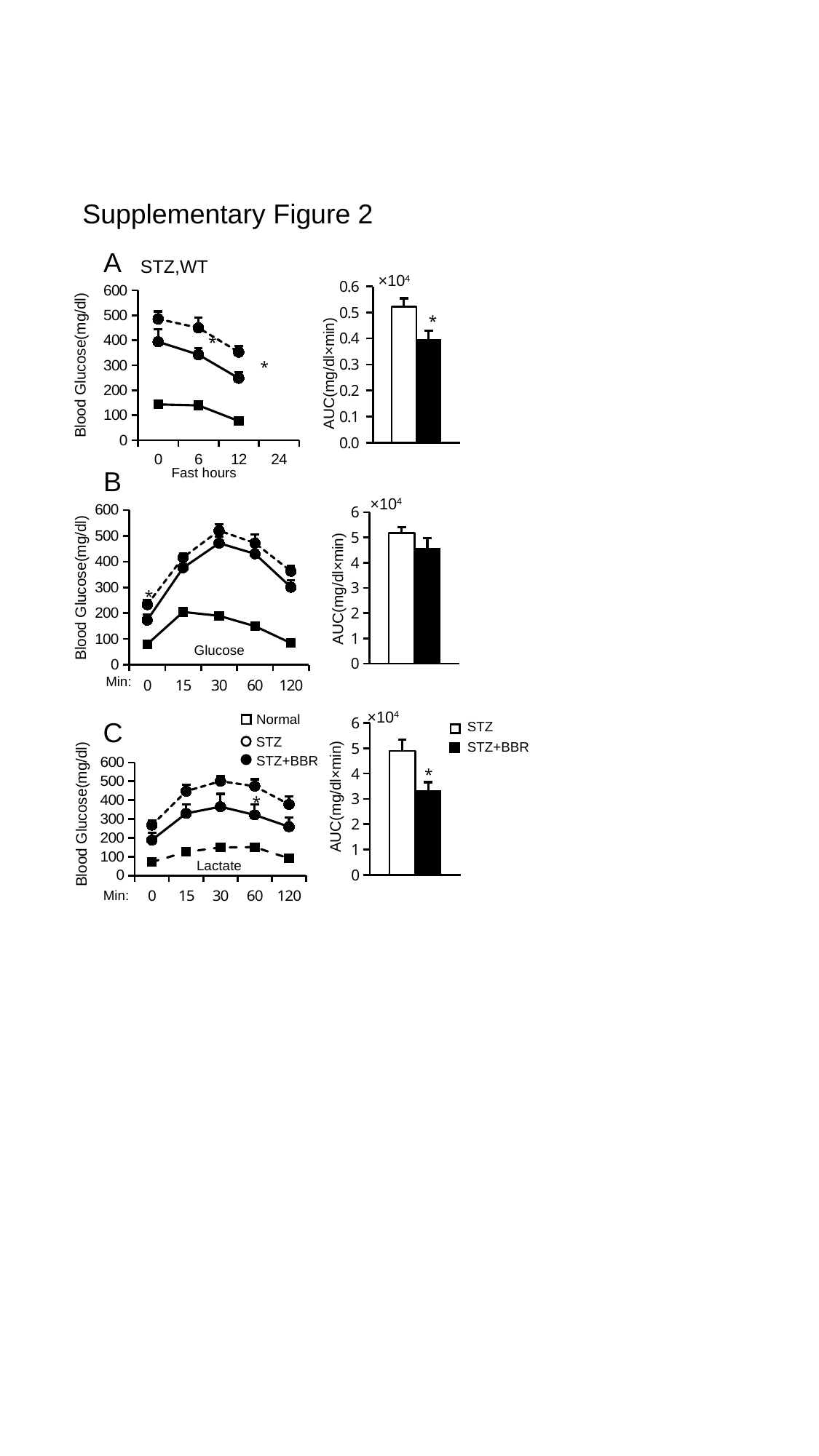
In the panel A AUC bar chart, which bar is taller, STZ or STZ+BBR? STZ How many time points are plotted along the x axis in the panel B Glucose line chart? 5 In the panel B Glucose line chart, at which minute does the STZ series reach its highest value? 30 How many series does the legend list for the line charts (Normal, STZ, STZ+BBR)? 3 How many series does the legend list for the AUC bar charts? 2 In the panel B AUC bar chart, is the value for STZ greater or less than 5? greater What kind of chart is the left-hand chart in panel A (Blood Glucose vs Fast hours)? line chart In the panel A AUC bar chart, is the value for STZ greater or less than 0.5? greater In the panel C AUC bar chart, is the value for STZ+BBR greater or less than 4? less What kind of chart is the right-hand AUC chart in panel A? bar chart In the panel A line chart, do the blood glucose values rise or fall as fast hours increase from 0 to 12? fall